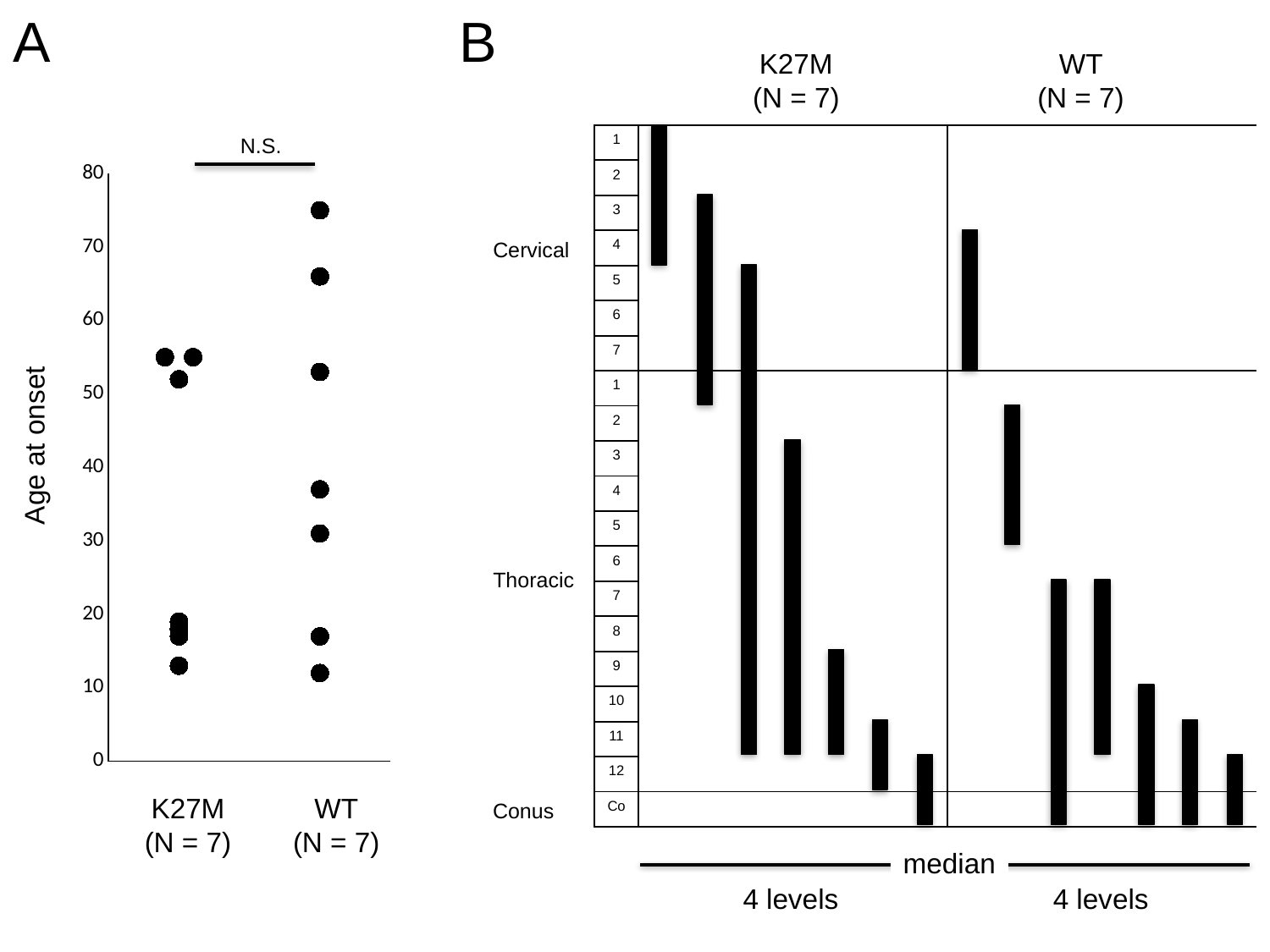
In panel A, how many patients are in the K27M group? 7 In panel A, which group contains the patient with the highest age at onset? WT In panel A, what is the label of the y axis? Age at onset In panel A, is the highest age at onset in the WT group greater or less than 70? greater In panel B, how many bars are drawn for the WT group? 7 In panel A, what kind of chart is shown? dot plot In panel A, how many groups are plotted along the x axis? 2 In panel A, what does the annotation above the two groups say about the comparison? N.S. In panel A, is the lowest age at onset in the K27M group greater or less than 20? less In panel B, what is the median number of levels for the K27M group? 4 levels In panel B, how many K27M bars include cervical levels? 3 In panel B, what is the median number of levels for the WT group? 4 levels